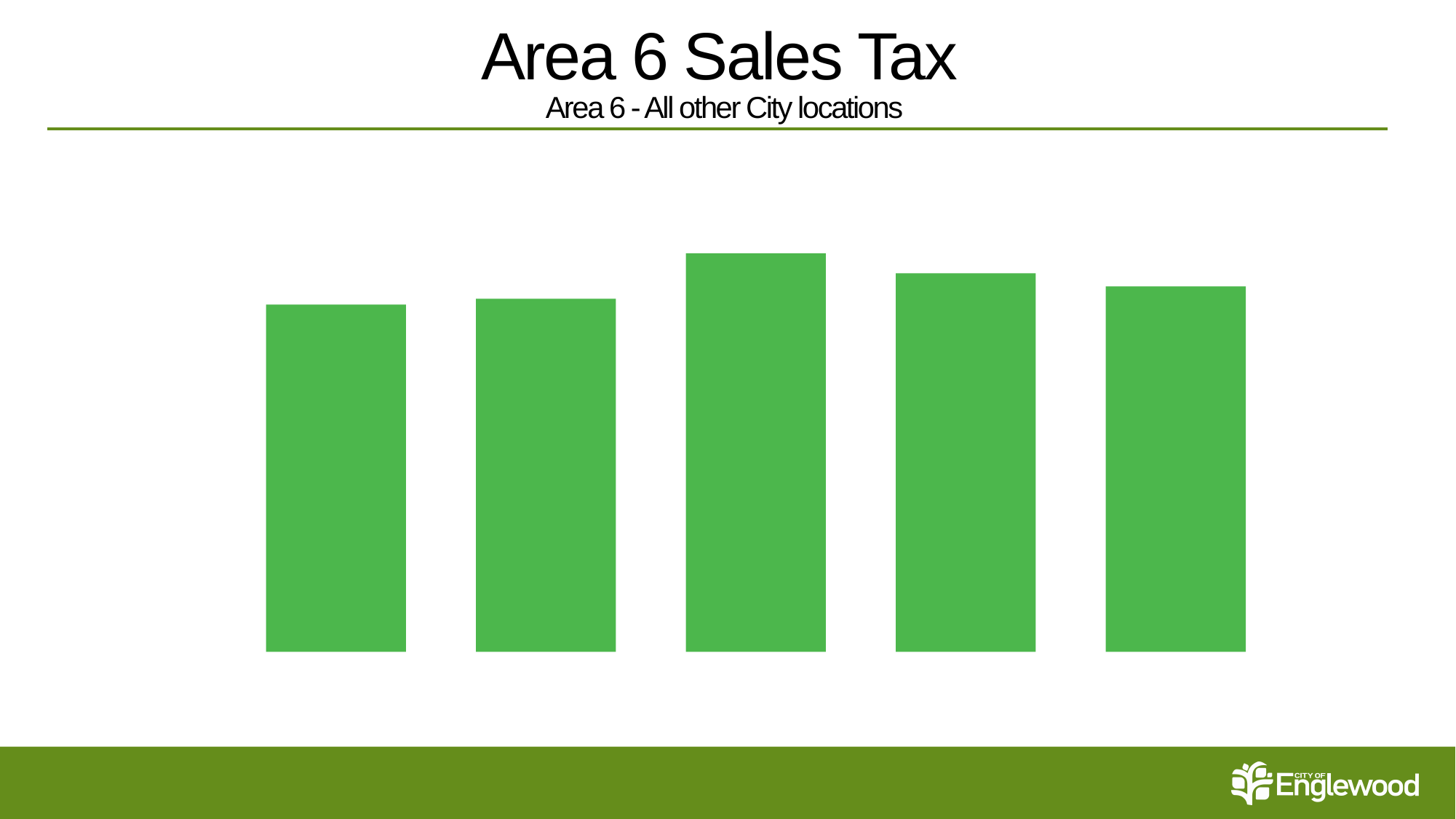
Is the fifth bar from the left taller or shorter than the third bar? shorter Which bar, counting from the left, is the tallest? the third bar Is the third bar from the left taller or shorter than the first bar? taller Do the bars rise or fall from the first bar to the third bar? rise What is the title of the slide containing the chart? Area 6 Sales Tax What kind of chart is shown on the slide? bar chart What colour are the bars in the chart? green Is the fourth bar from the left taller or shorter than the second bar? taller Do the bars rise or fall from the third bar to the fifth bar? fall How many bars are plotted in the chart? 5